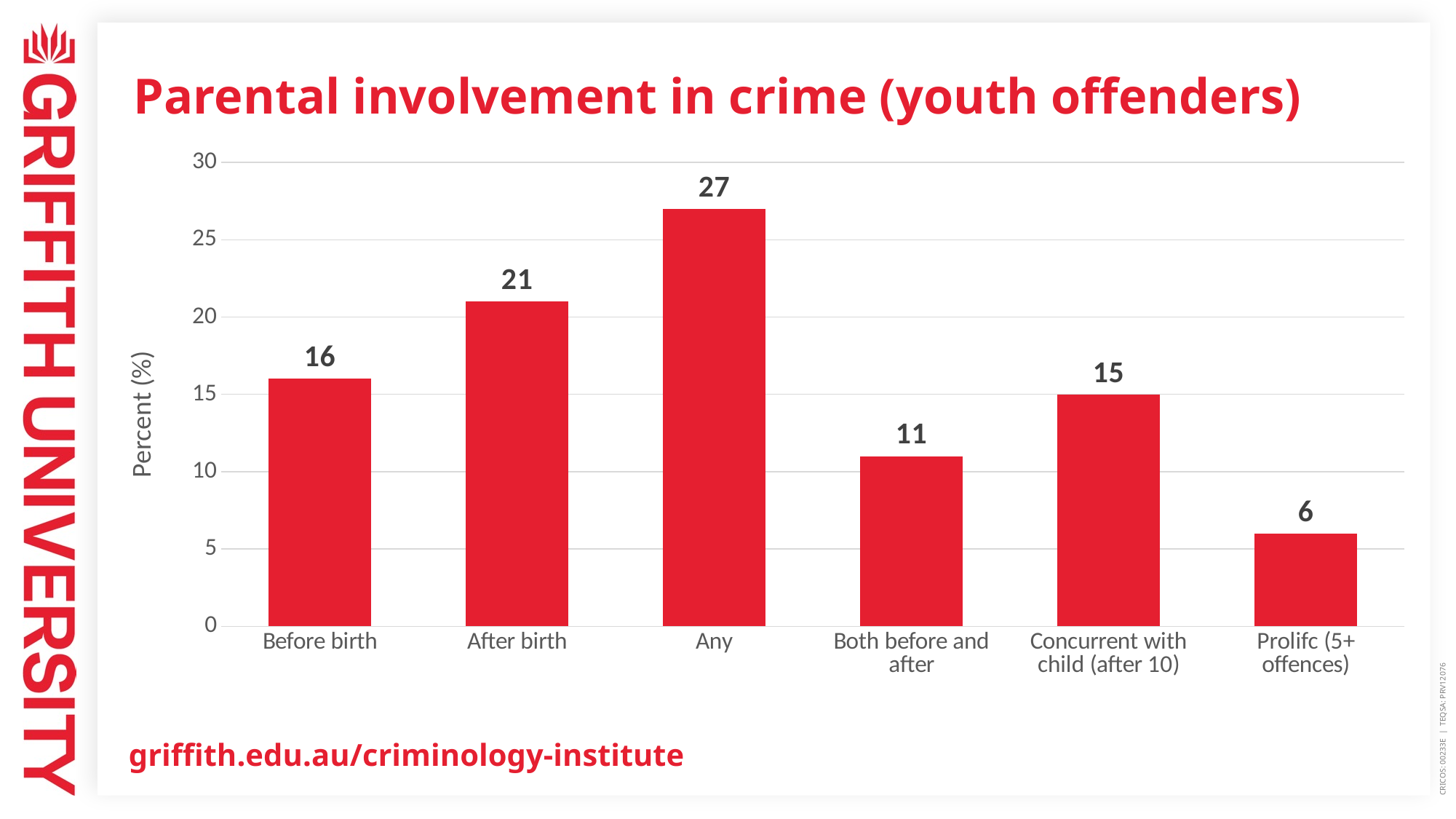
What is the value for "Any" parental involvement in crime? 27 How many categories are shown on the x axis? 6 What is the difference between the values for "Any" and "Both before and after"? 16 Is the value for "After birth" greater or less than 20? greater What is the difference between the values for "After birth" and "Before birth"? 5 What percentage is shown for "Before birth"? 16 Which category has the lowest value? Prolifc (5+ offences) What kind of chart is shown on the slide? Bar chart Which is larger, the value for "Before birth" or the value for "Concurrent with child (after 10)"? Before birth Which category has the highest value? Any What is the value for "Concurrent with child (after 10)"? 15 What is the title of the chart? Parental involvement in crime (youth offenders)